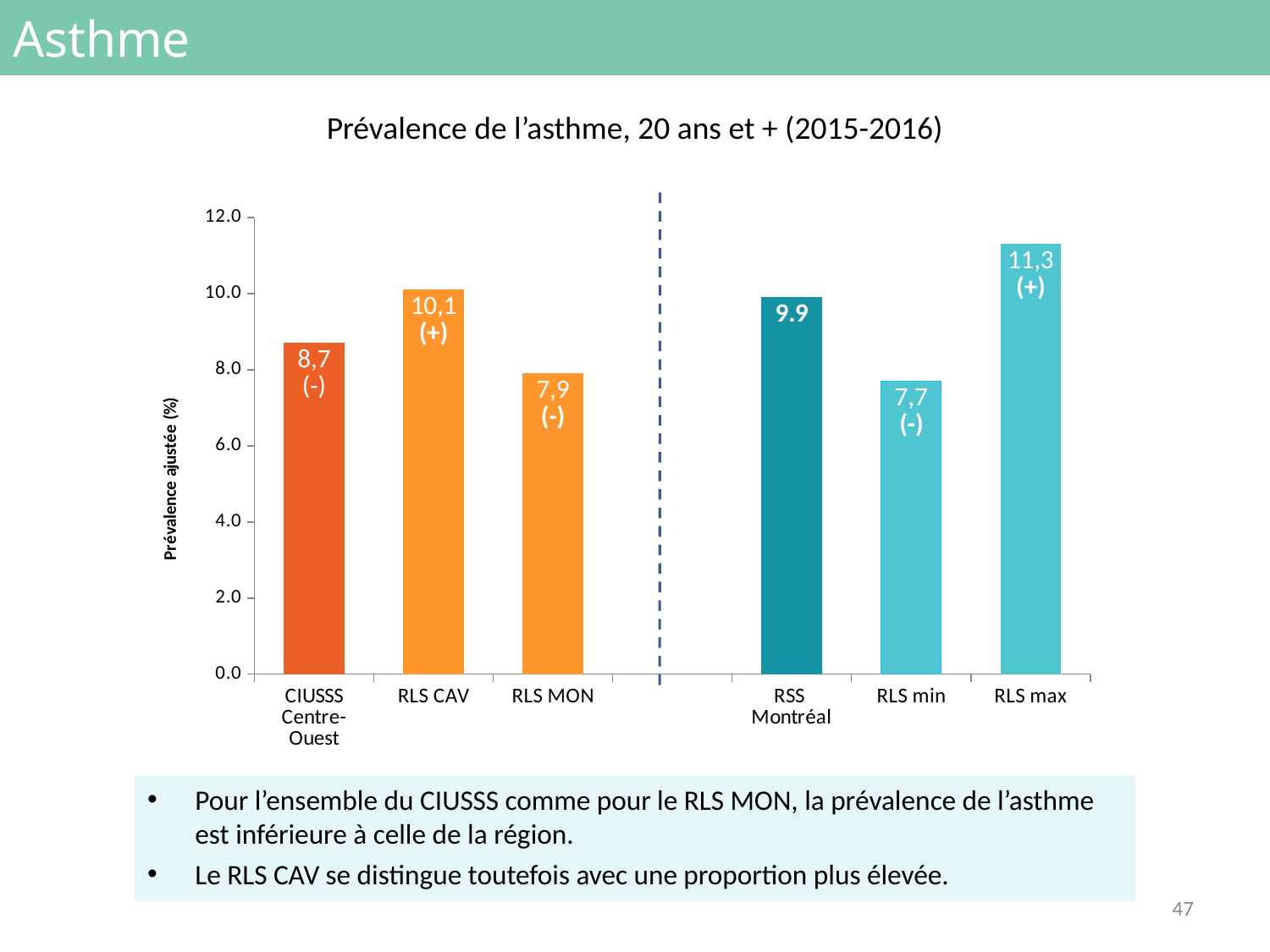
Which is larger, the value for RLS CAV or the value for RSS Montréal? RLS CAV What is the value for CIUSSS Centre-Ouest? 8,7 What is the value for RSS Montréal? 9.9 What is the value for RLS min? 7,7 What kind of chart is shown on the slide? Bar chart Which category has the lowest value? RLS min What is the difference between the values for RLS CAV and RLS MON? 2,2 How many categories are shown on the chart? 6 What is the title of the chart? Prévalence de l'asthme, 20 ans et + (2015-2016) What is the value for RLS CAV? 10,1 What is the difference between the values for RLS max and RLS min? 3,6 Which category has the highest value? RLS max